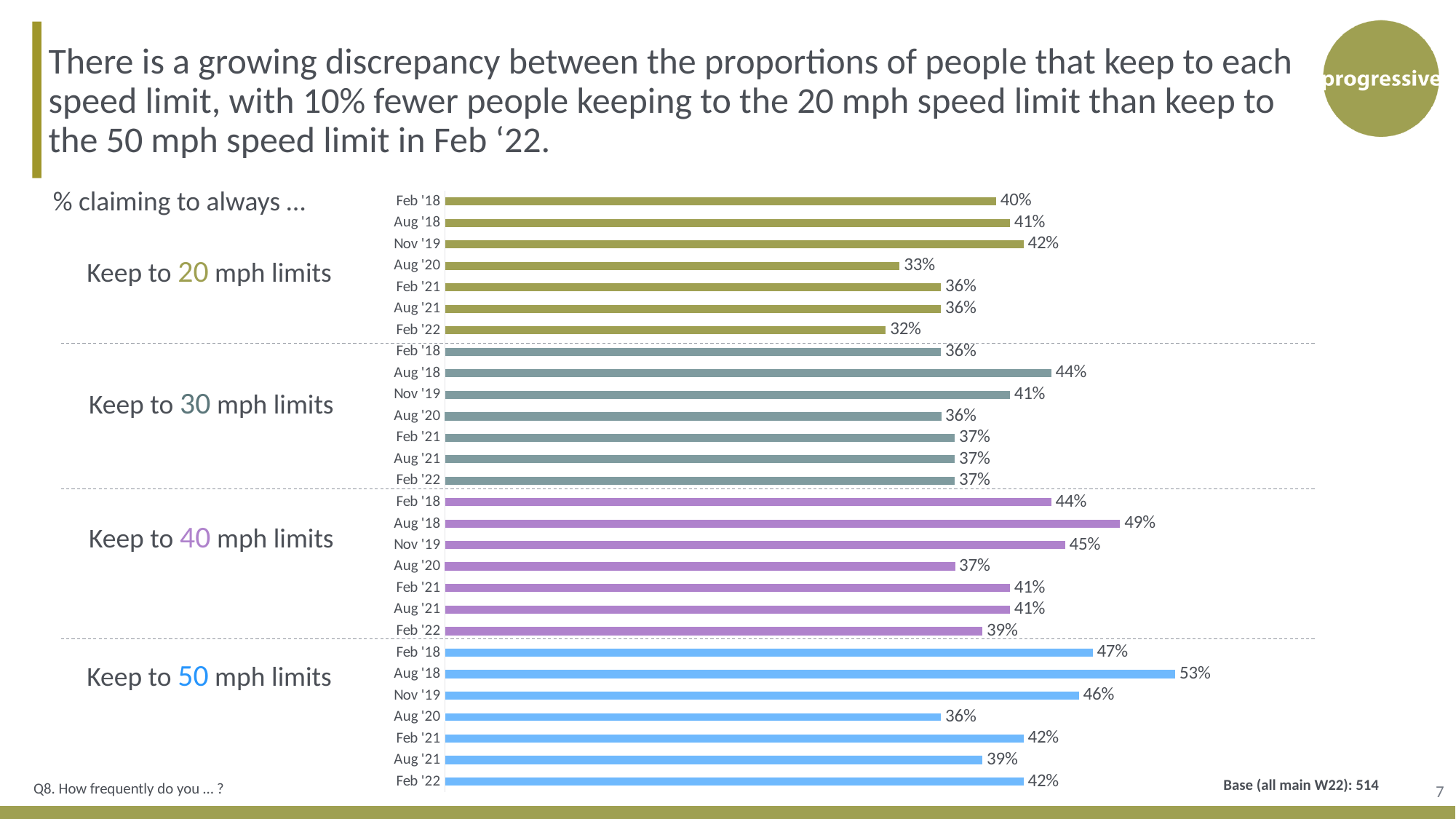
Did the percentage keeping to 50 mph limits rise or fall between Nov '19 and Aug '20? Fall How many survey waves are shown for each speed limit? 7 Which is larger: the Aug '18 value for keeping to 40 mph limits or the Aug '18 value for keeping to 30 mph limits? Keep to 40 mph limits How many speed limit groups are shown in the chart? 4 What percentage claimed to always keep to 20 mph limits in Feb '22? 32% What colour are the bars for keeping to 40 mph limits? Purple What type of chart is used on this slide? Bar chart In which survey wave was the percentage keeping to 20 mph limits lowest? Feb '22 What percentage claimed to always keep to 50 mph limits in Aug '18? 53% What percentage claimed to always keep to 40 mph limits in Aug '20? 37% In which survey wave was the percentage keeping to 30 mph limits highest? Aug '18 What is the difference between the Feb '22 percentages for keeping to 50 mph limits and keeping to 20 mph limits? 10%